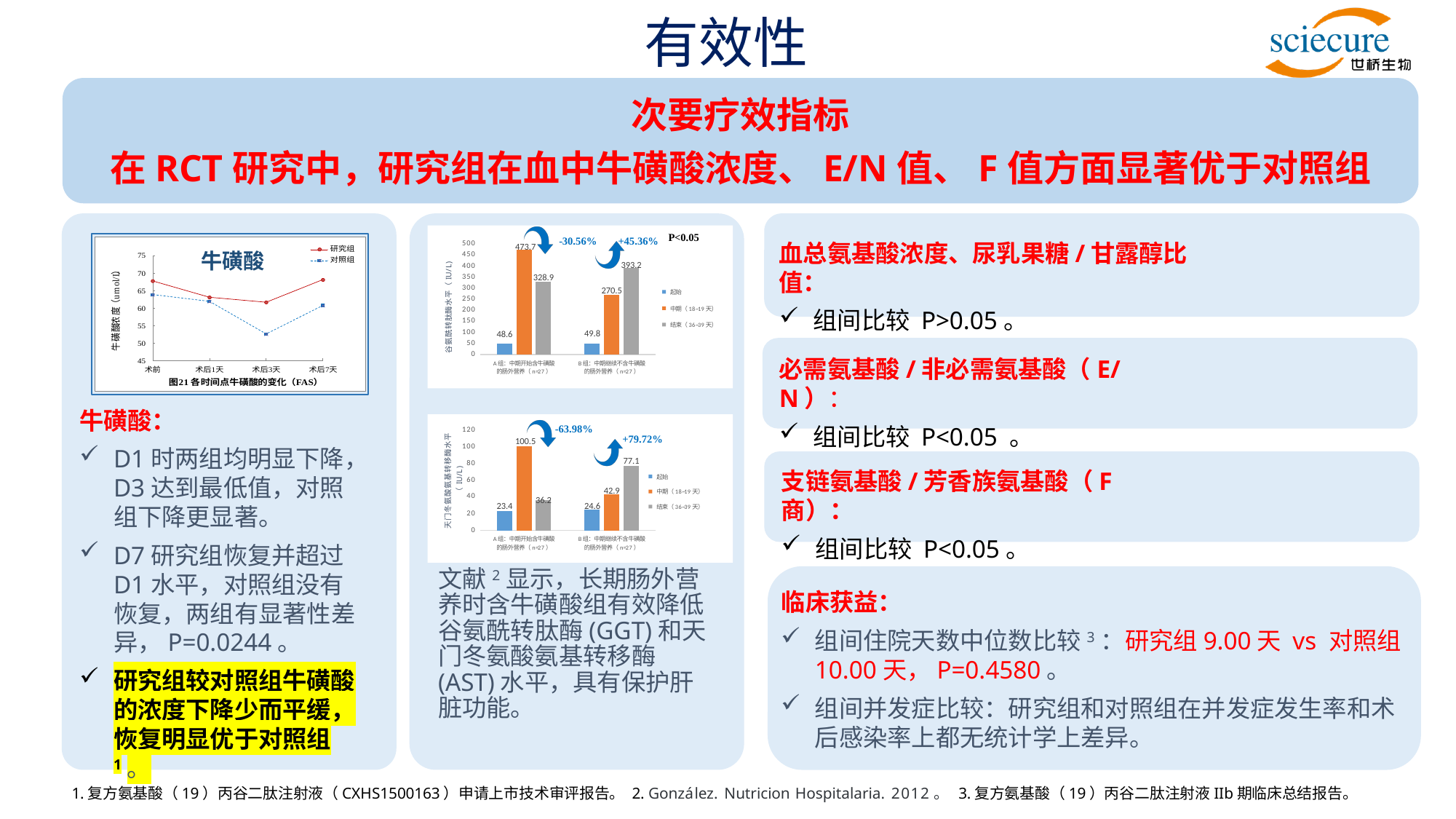
How many time points are shown on the x axis of the 牛磺酸 line chart on the left? 4 In the top bar chart in the middle of the slide (GGT), what is the difference between the 中期 and 结束 values for A组? 144.8 In the bottom bar chart in the middle of the slide (AST), what is the difference between the 起始 values of A组 and B组? 1.2 In the bottom bar chart in the middle of the slide (AST), what is the 结束 value for B组? 77.1 In the top bar chart in the middle of the slide (GGT), what is the 结束 value for B组? 393.2 In the top bar chart in the middle of the slide (GGT), which bar is the highest? A组 中期 (473.7) What kind of chart is the 牛磺酸 chart on the left of the slide? Line chart In the bottom bar chart in the middle of the slide (AST), what is the 中期 value for A组? 100.5 In the 牛磺酸 line chart on the left, is the 对照组 value at 术后3天 greater or less than 55? less In the bottom bar chart in the middle of the slide (AST), which is larger for B组: the 中期 value or the 结束 value? 结束 (77.1) In the top bar chart in the middle of the slide (GGT), what is the 中期 value for A组? 473.7 How many series does the legend of the top bar chart in the middle of the slide (GGT) list? 3